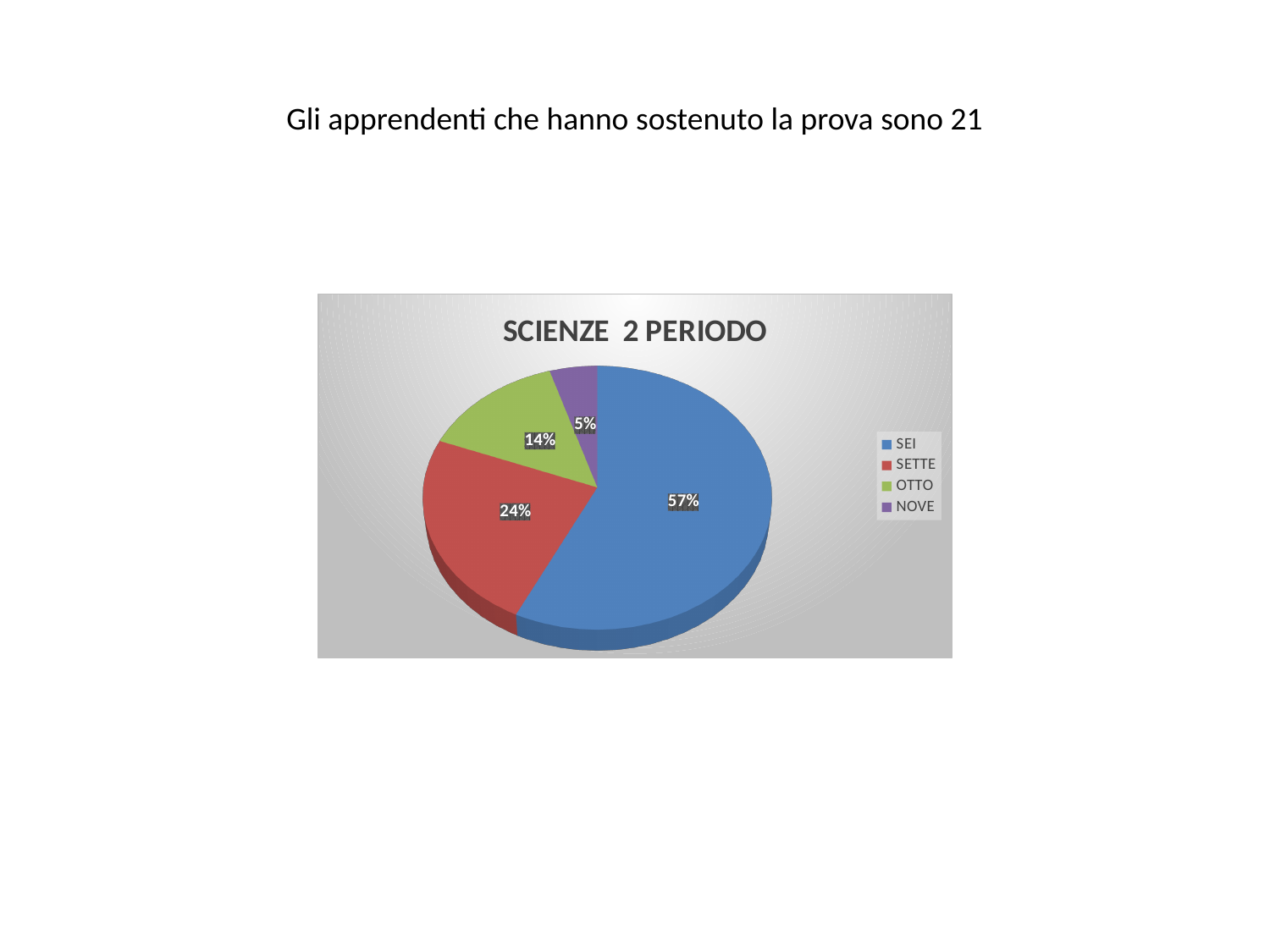
What type of chart is shown on the slide? Pie chart What is the title of the chart? SCIENZE 2 PERIODO What colour is the slice for OTTO? Green What share of the pie does SETTE represent? 24% What is the difference in percentage points between the SEI and SETTE slices? 33 What share of the pie does NOVE represent? 5% Which slice is larger, OTTO or SETTE? SETTE What share of the pie does OTTO represent? 14% Which category has the largest slice of the pie? SEI Which category has the smallest slice of the pie? NOVE How many categories does the pie chart show? 4